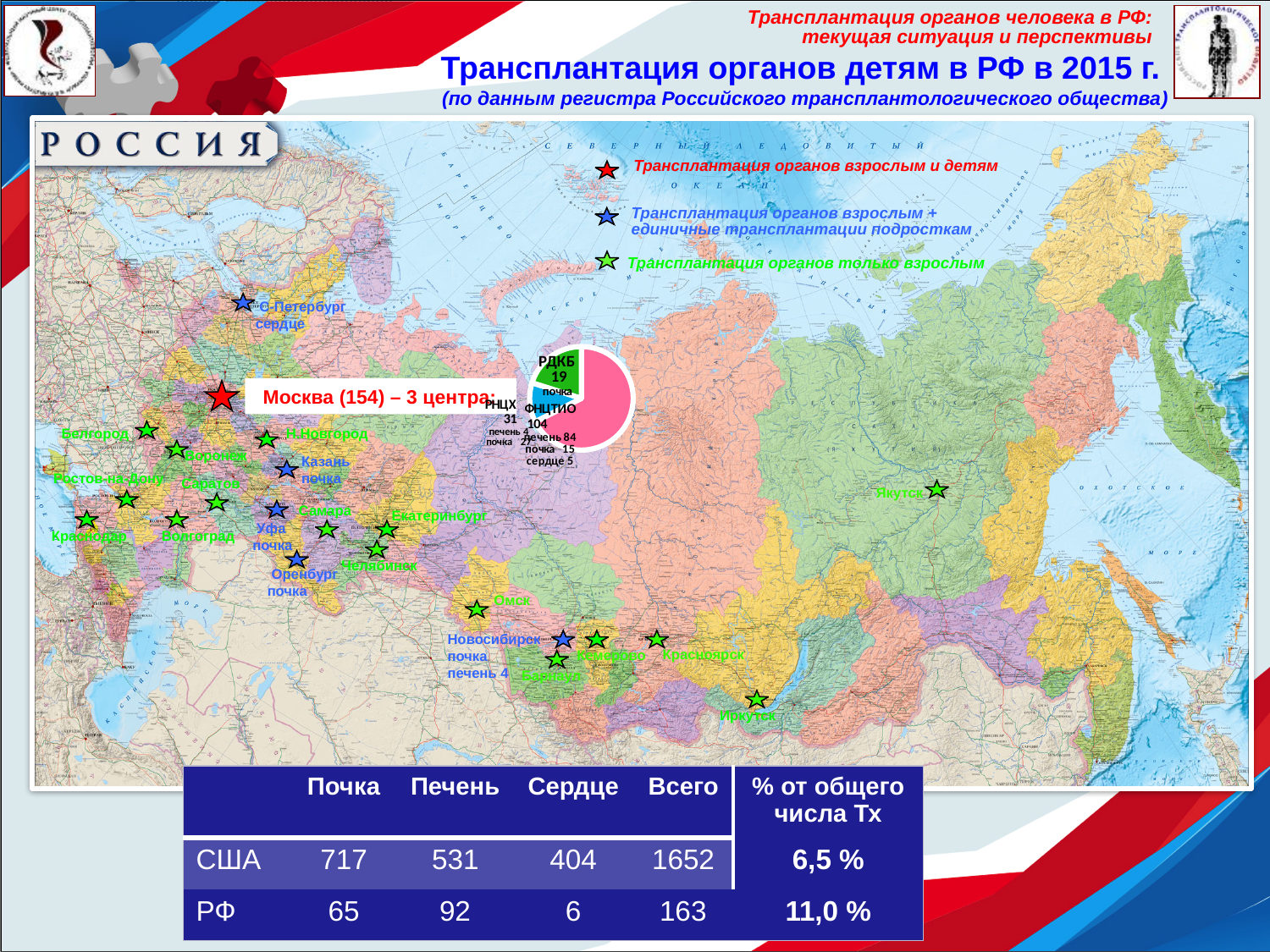
Which center has the largest slice in the pie chart? ФНЦТИО What is the difference between the values for ФНЦТИО and РДКБ in the pie chart? 85 How many liver (печень) transplants are listed for ФНЦТИО in the pie chart labels? 84 What is the total number of transplants for Moscow shown next to the pie chart? 154 What kind of chart is shown on the map of Russia? pie chart In the pie chart, what is the value for РНЦХ? 31 Which is larger in the pie chart, РНЦХ or РДКБ? РНЦХ In the pie chart, what is the value for ФНЦТИО? 104 What colour is the largest slice of the pie chart? pink In the pie chart, what is the value for РДКБ? 19 How many slices does the pie chart on the map have? 3 Which center has the smallest slice in the pie chart? РДКБ